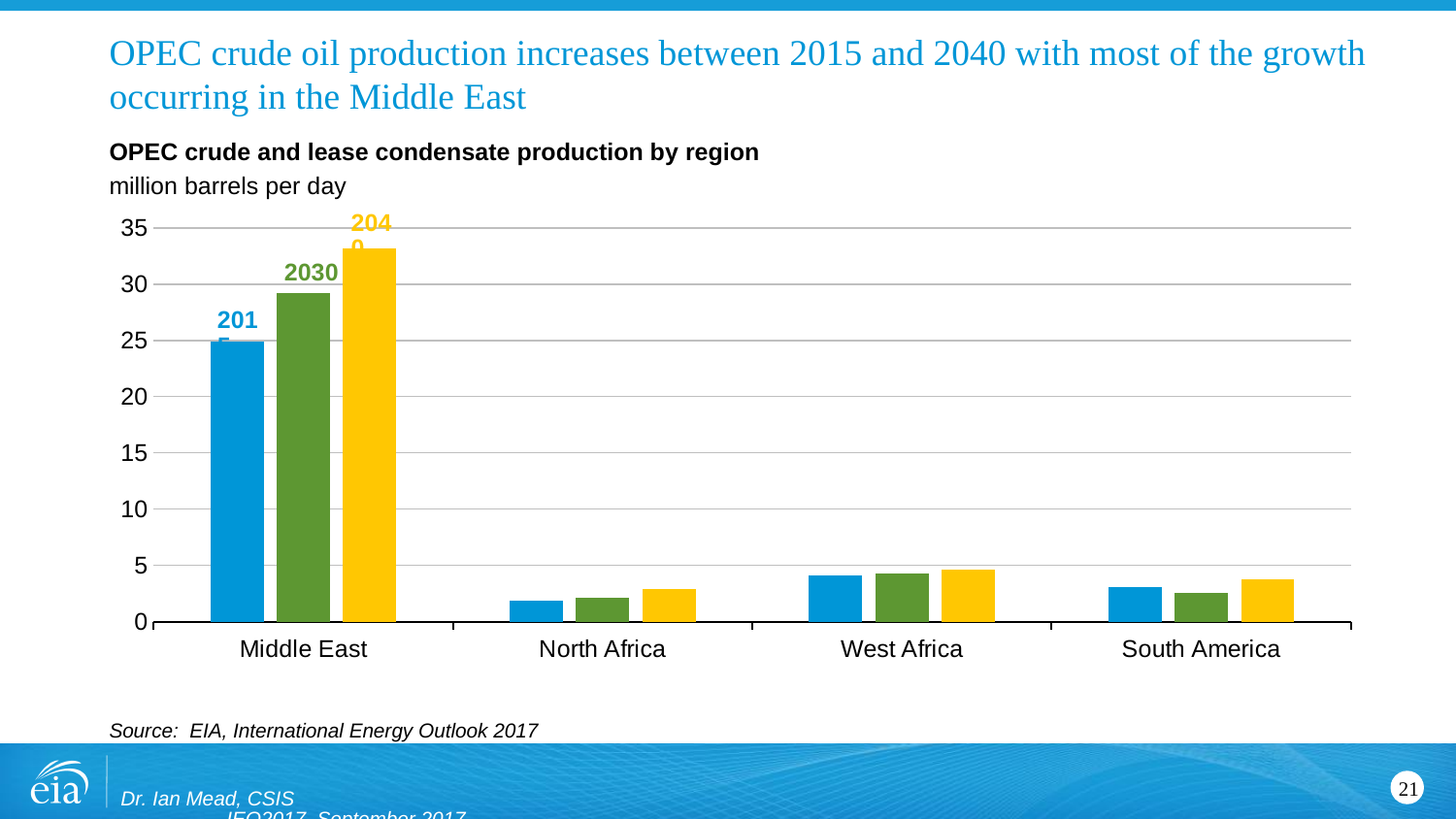
What unit is the chart's y axis measured in? million barrels per day How many years (series) are plotted for each region? 3 Which region has the highest crude and lease condensate production in every year shown? Middle East For South America, which is larger: production in 2015 or in 2030? 2015 Which region has the lowest production in 2015? North Africa For the Middle East, which is larger: production in 2030 or in 2040? 2040 Is the Middle East production value for 2015 greater or less than 20 million barrels per day? greater Is the North Africa production value for 2040 greater or less than 5 million barrels per day? less What kind of chart is shown on the slide? bar chart Does Middle East production rise or fall from 2015 to 2040? rise How many regions are shown on the x axis of the chart? 4 Is the Middle East production value for 2040 greater or less than 30 million barrels per day? greater